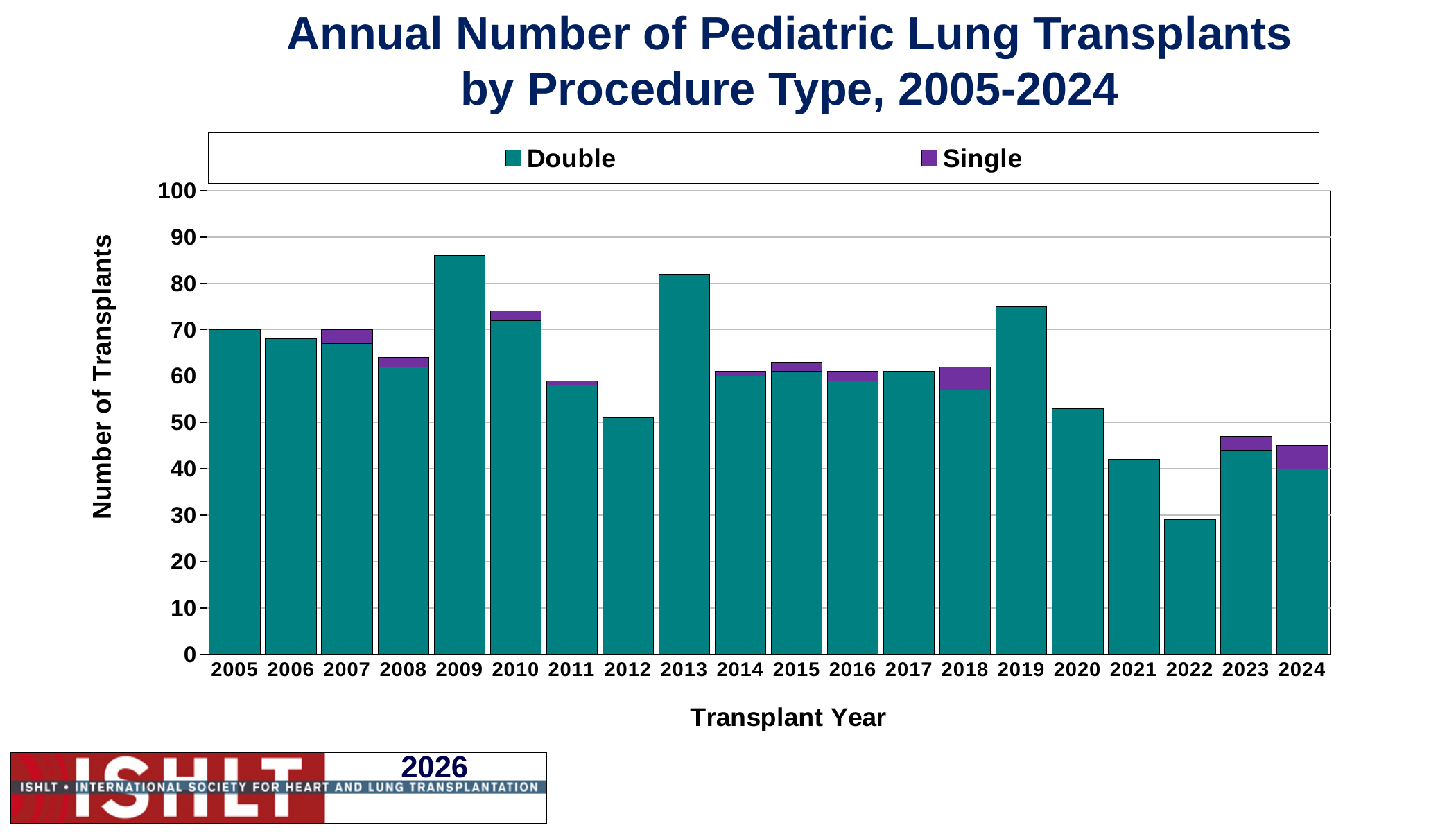
Is the total number of transplants in 2023 greater or less than 50? less Is the total number of transplants in 2009 greater or less than 80? greater What kind of chart is shown on the slide? bar chart Which series is shown in purple in the legend? Single Do the total number of transplants rise or fall from 2019 to 2022? fall Is the total number of transplants in 2019 greater or less than 70? greater Which transplant year has the highest total number of transplants? 2009 How many series does the legend list? 2 How many transplant years are shown on the x axis? 20 Which year has a higher total number of transplants, 2019 or 2020? 2019 Which transplant year has the lowest total number of transplants? 2022